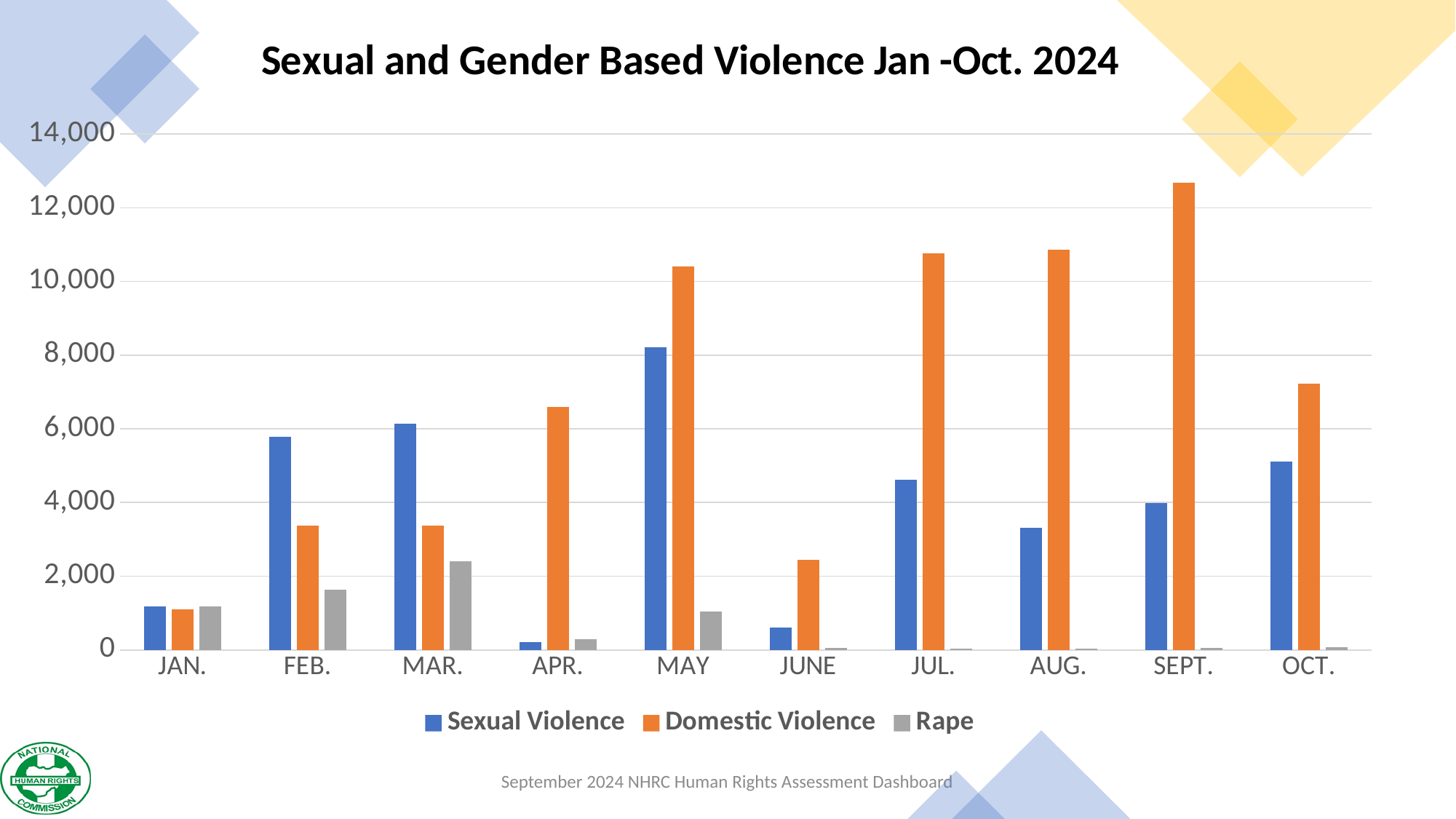
What is the title of the chart? Sexual and Gender Based Violence Jan -Oct. 2024 What kind of chart is shown on the slide? bar chart In MAR., which is larger: Sexual Violence or Domestic Violence? Sexual Violence Is the Sexual Violence value for MAY greater or less than 8,000? greater In which month is the Domestic Violence value highest? SEPT. In which month is the Sexual Violence value highest? MAY In which month is the Sexual Violence value lowest? APR. In which month is the Rape value highest? MAR. Is the Rape value for MAR. greater or less than 2,000? greater Is the Domestic Violence value for SEPT. greater or less than 12,000? greater How many months are shown on the x axis? 10 How many series does the legend list? 3